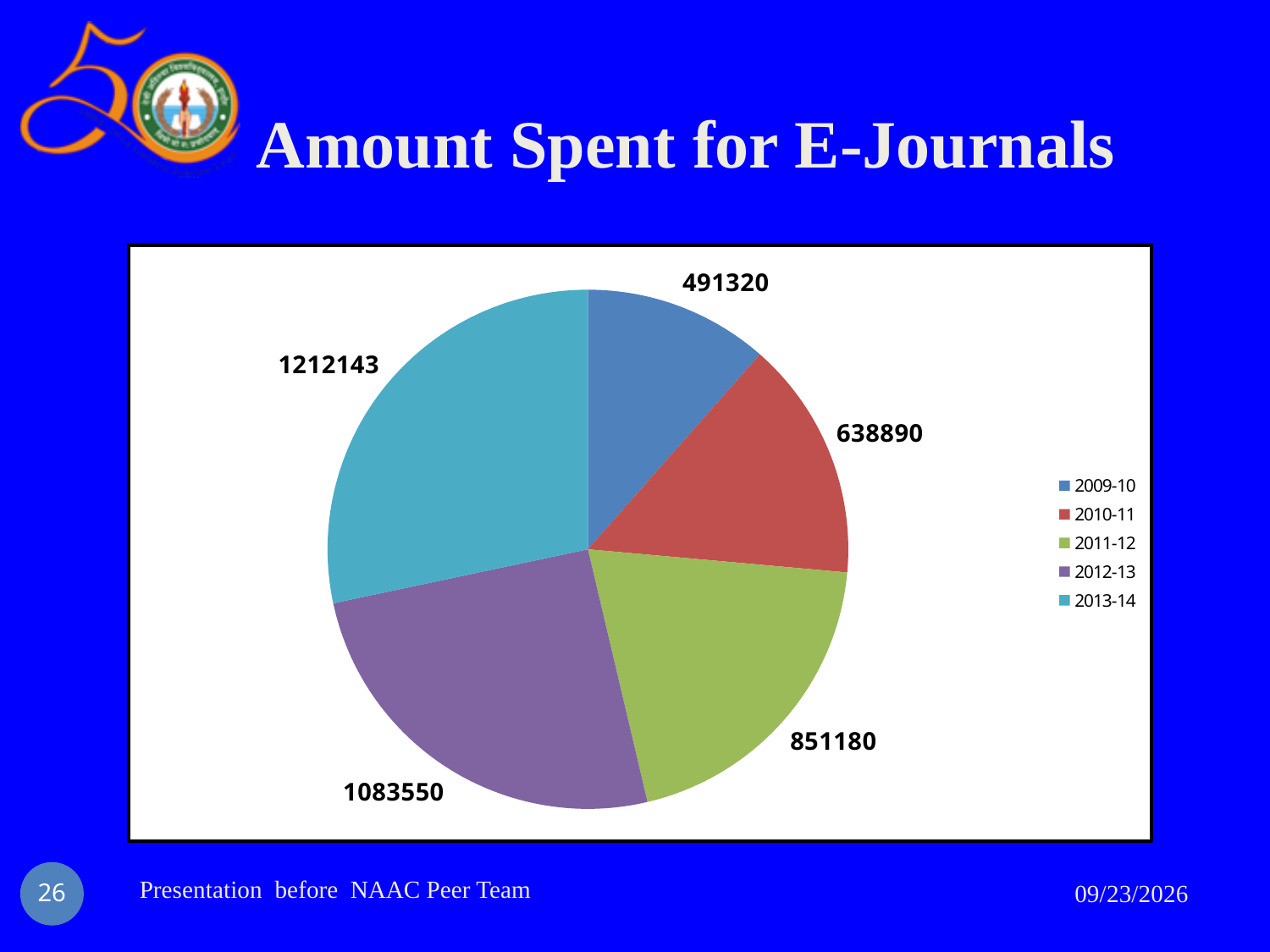
What type of chart is shown on the slide? Pie chart What amount was spent on e-journals in 2013-14? 1212143 Which year has the largest amount spent on e-journals? 2013-14 What is the title of the chart? Amount Spent for E-Journals What amount was spent on e-journals in 2011-12? 851180 Does the amount spent on e-journals rise or fall from 2009-10 to 2013-14? Rise Which year has the smallest amount spent on e-journals? 2009-10 Which is larger, the amount spent in 2010-11 or in 2012-13? 2012-13 How many entries does the legend list? 5 What is the difference between the amounts spent in 2013-14 and 2009-10? 720823 What amount was spent on e-journals in 2009-10? 491320 How many slices does the pie chart have? 5